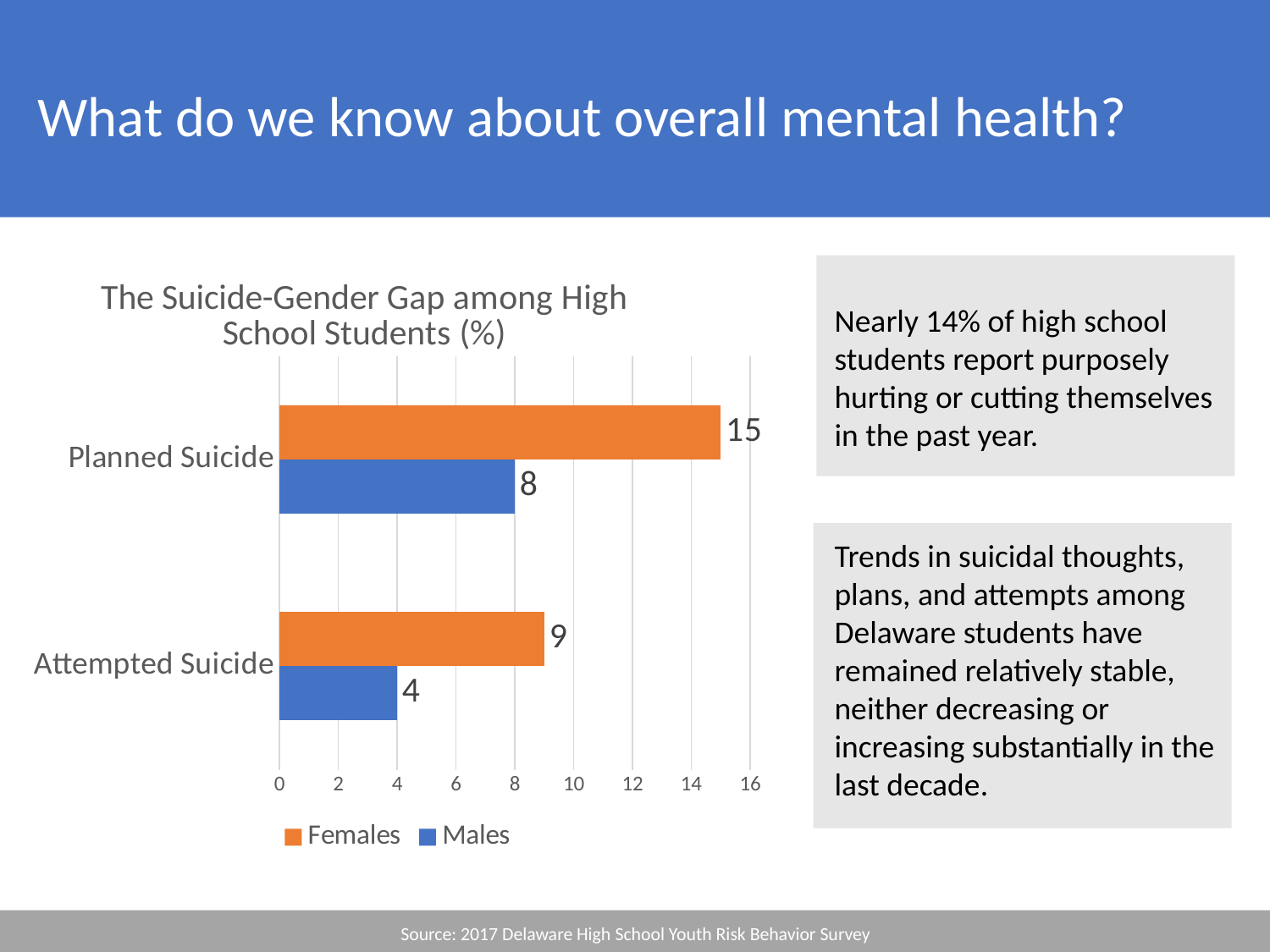
Which category has the highest value for Females? Planned Suicide What kind of chart is shown on the slide? Bar chart What is the difference between the Females and Males values for Planned Suicide? 7 What is the value for Females for Attempted Suicide? 9 What is the value for Males for Attempted Suicide? 4 What is the value for Males for Planned Suicide? 8 Which is larger for Attempted Suicide, the Females value or the Males value? Females How many categories are shown on the chart? 2 How many series does the legend list? 2 What is the title of the chart? The Suicide-Gender Gap among High School Students (%) What is the value for Females for Planned Suicide? 15 Which category has the lowest value for Males? Attempted Suicide